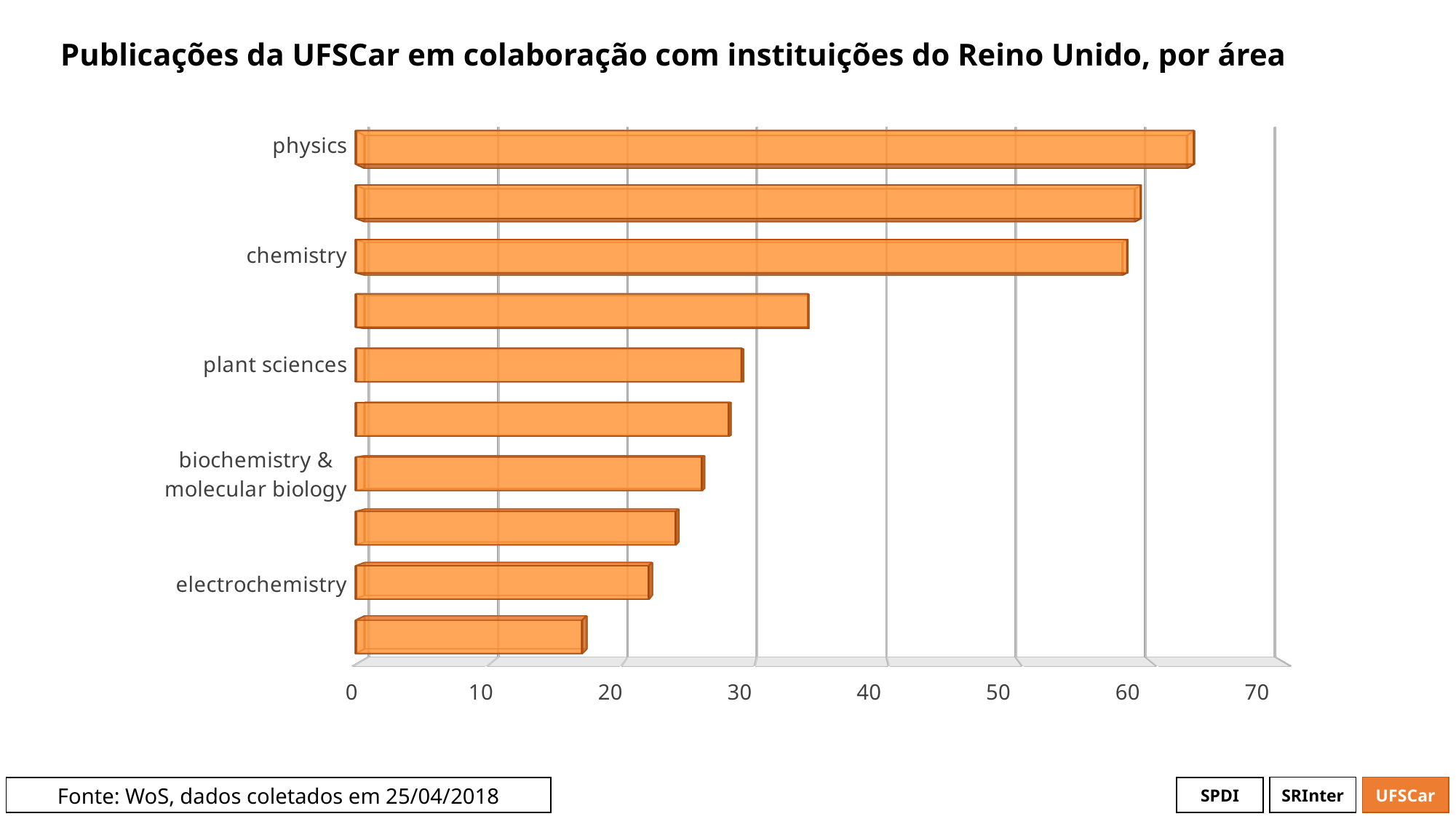
Which has more publications, plant sciences or electrochemistry? plant sciences Which has more publications, physics or chemistry? physics What kind of chart is shown on the slide? bar chart What is the title of the chart? Publicações da UFSCar em colaboração com instituições do Reino Unido, por área Is the value for plant sciences greater or less than 20? greater Is the value for chemistry greater or less than 50? greater Which labeled area has the highest number of publications? physics Is the value for biochemistry & molecular biology greater or less than 30? less Do the bar lengths increase or decrease from the top of the chart to the bottom? decrease How many bars does the chart contain? 10